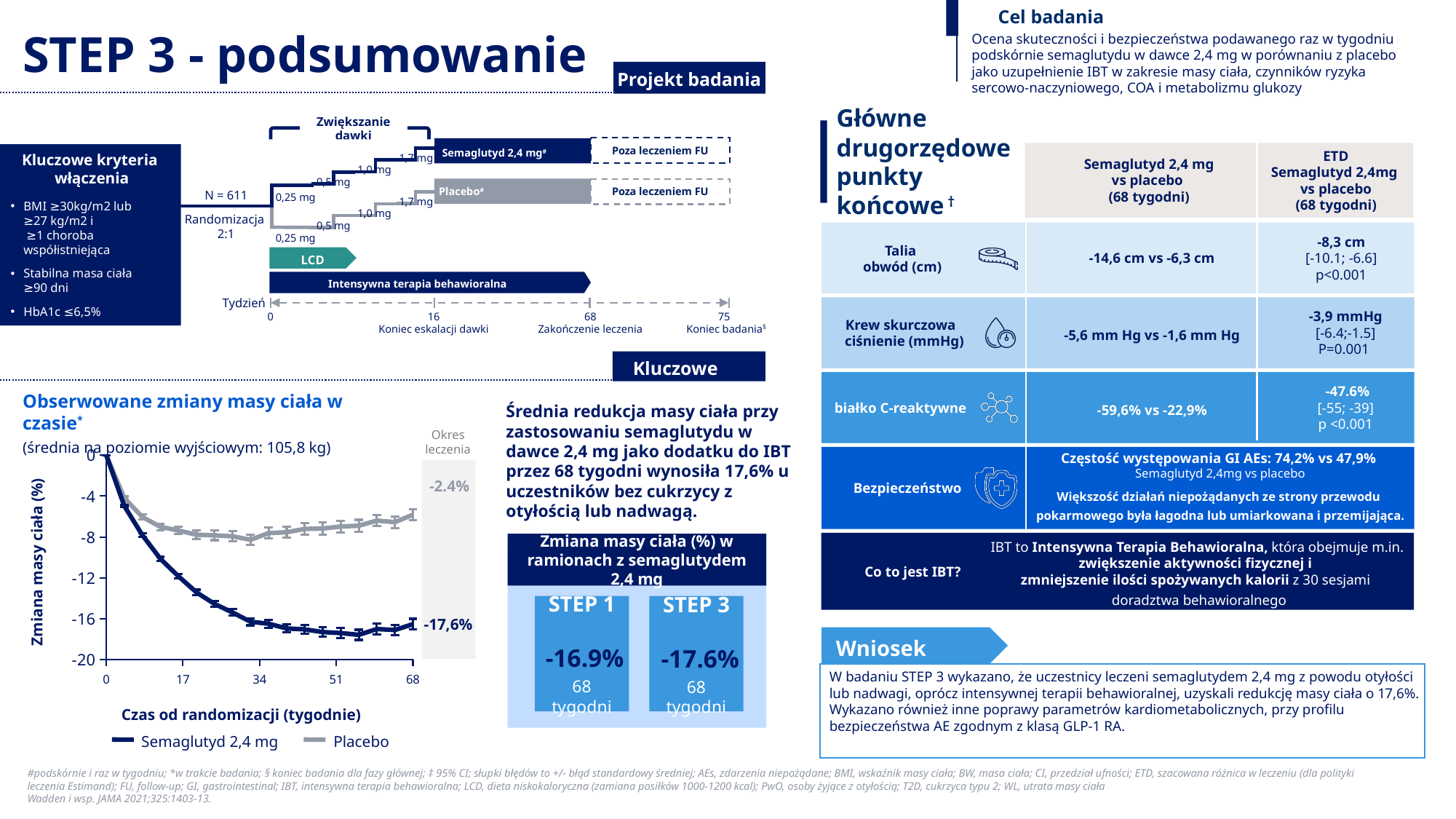
In the chart "Obserwowane zmiany masy ciała w czasie", does the Semaglutyd 2,4 mg line rise or fall from week 0 to week 34? fall In the chart "Obserwowane zmiany masy ciała w czasie", what is the last tick value shown on the x axis? 68 In the chart "Obserwowane zmiany masy ciała w czasie", is the Placebo value at week 17 greater or less than -12? greater In the chart "Obserwowane zmiany masy ciała w czasie", what is the label of the x axis? Czas od randomizacji (tygodnie) In the chart "Obserwowane zmiany masy ciała w czasie", is the Placebo value at week 34 greater or less than -4? less In the chart "Obserwowane zmiany masy ciała w czasie", what is the label of the y axis? Zmiana masy ciała (%) In the chart "Obserwowane zmiany masy ciała w czasie", which series shows the larger weight reduction at week 68? Semaglutyd 2,4 mg In the chart "Obserwowane zmiany masy ciała w czasie", what is the body weight change for Semaglutyd 2,4 mg at week 68? -17,6% In the chart "Obserwowane zmiany masy ciała w czasie", is the Semaglutyd 2,4 mg value at week 34 greater or less than -12? less What type of chart is "Obserwowane zmiany masy ciała w czasie"? line chart In the chart "Obserwowane zmiany masy ciała w czasie", what is the body weight change for Placebo at week 68? -2.4% In the chart "Obserwowane zmiany masy ciała w czasie", how many series does the legend list? 2